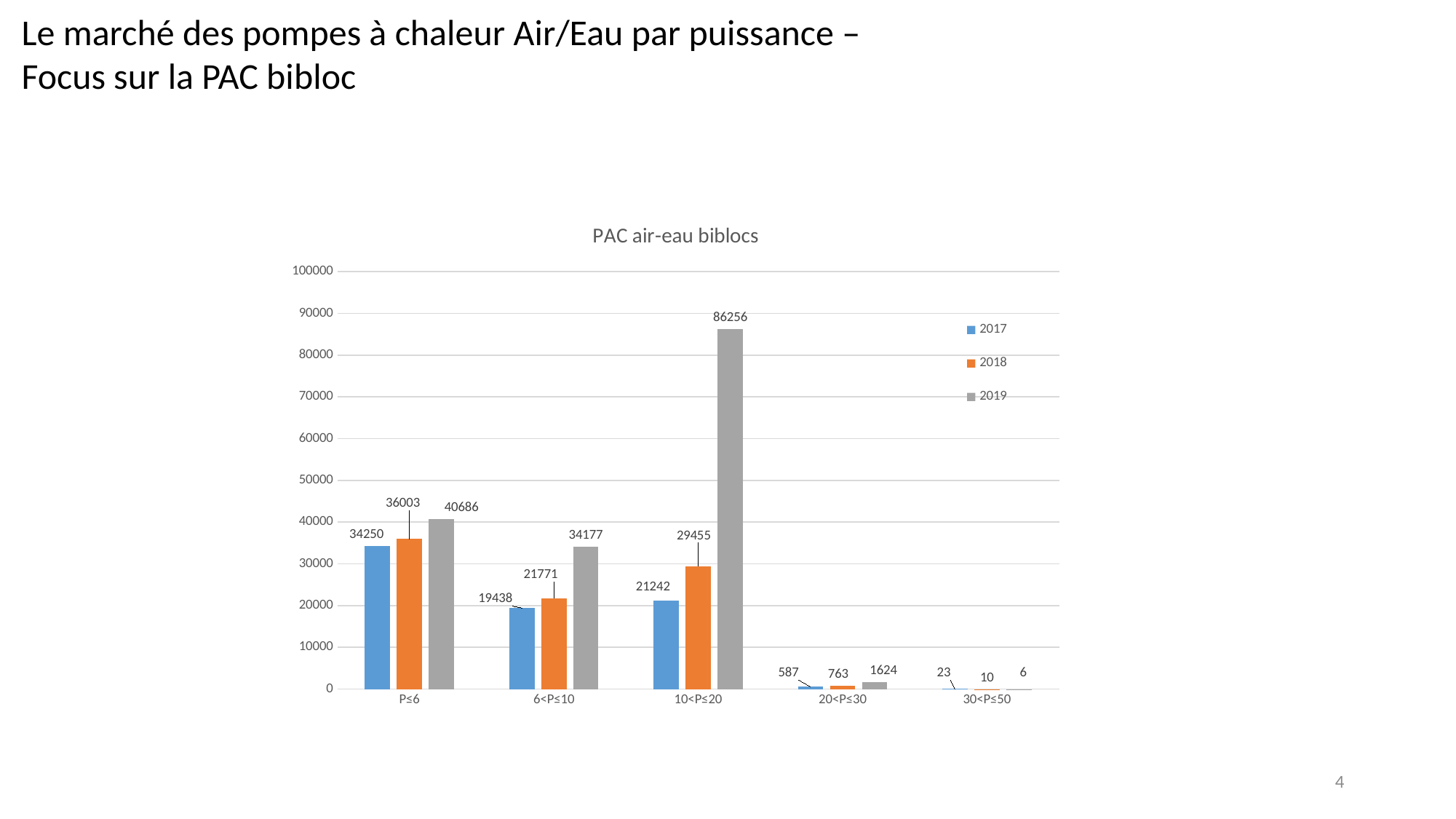
What is the value for 2017 in the P≤6 category? 34250 Which category has the lowest value for 2017? 30<P≤50 How many power categories are shown on the x axis? 5 Which is larger: the 2017 value for P≤6 or the 2017 value for 10<P≤20? P≤6 What type of chart is shown on the slide? Bar chart What is the value for 2019 in the 10<P≤20 category? 86256 Which category has the highest value for 2019? 10<P≤20 What is the value for 2019 in the 20<P≤30 category? 1624 What is the difference between the 2019 and 2018 values in the 10<P≤20 category? 56801 What is the value for 2018 in the 6<P≤10 category? 21771 Is the value for 2019 in the P≤6 category greater or less than 40000? greater How many series does the legend list? 3